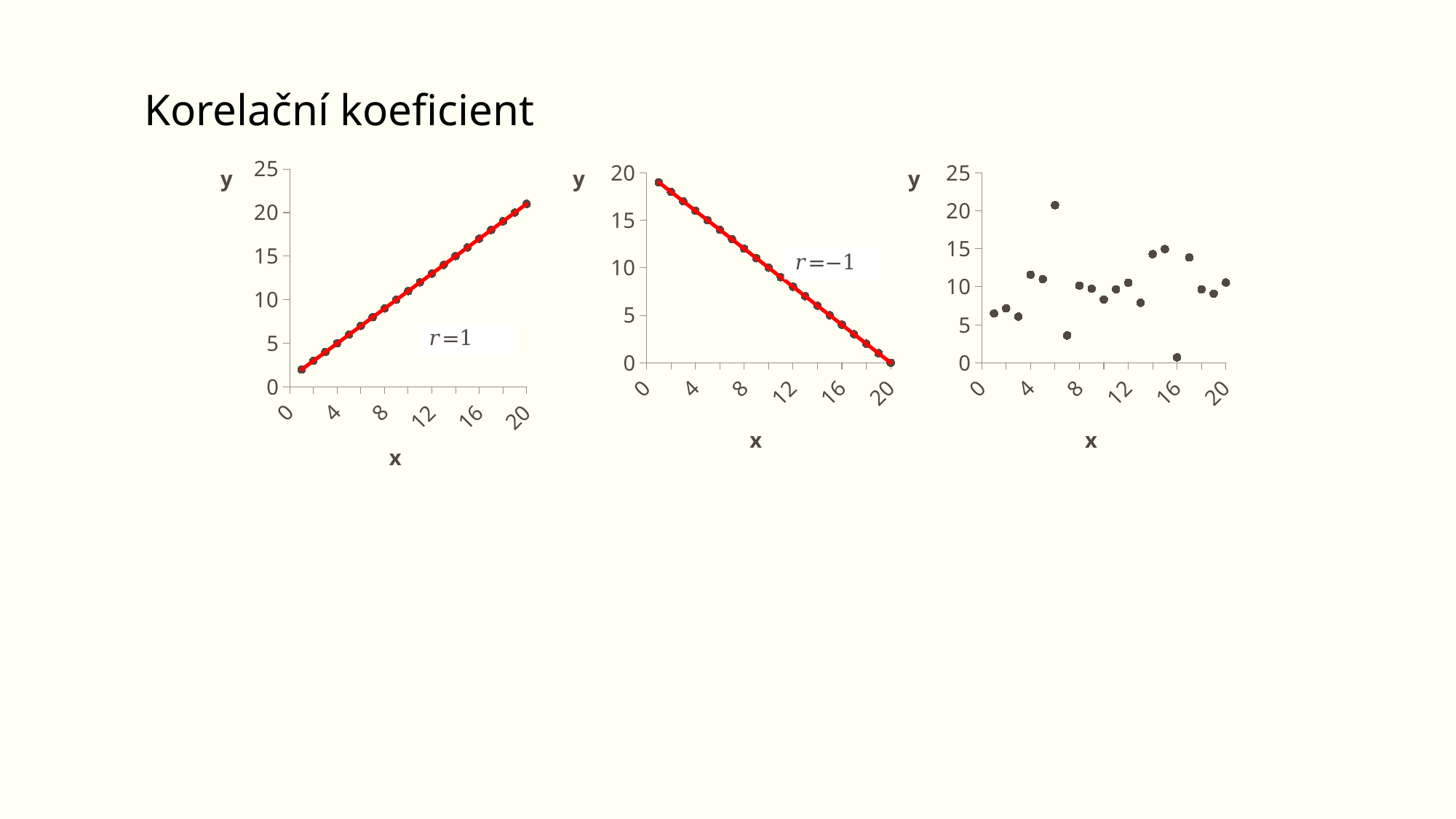
What correlation coefficient is printed on the middle chart? r=−1 In the middle chart (r=−1), is the y value at x=16 greater or less than 5? less In the right chart, at which x value is the lowest y value plotted? 16 In the left chart (r=1), do the y values rise or fall as x increases? rise What correlation coefficient is printed on the left chart? r=1 In the right chart, is the y value at x=6 greater or less than 15? greater In the left chart (r=1), is the y value at x=12 greater or less than 10? greater What kind of chart is the left chart (labelled r=1)? scatter chart In the middle chart (r=−1), do the y values rise or fall as x increases? fall In the right chart, at which x value is the highest y value plotted? 6